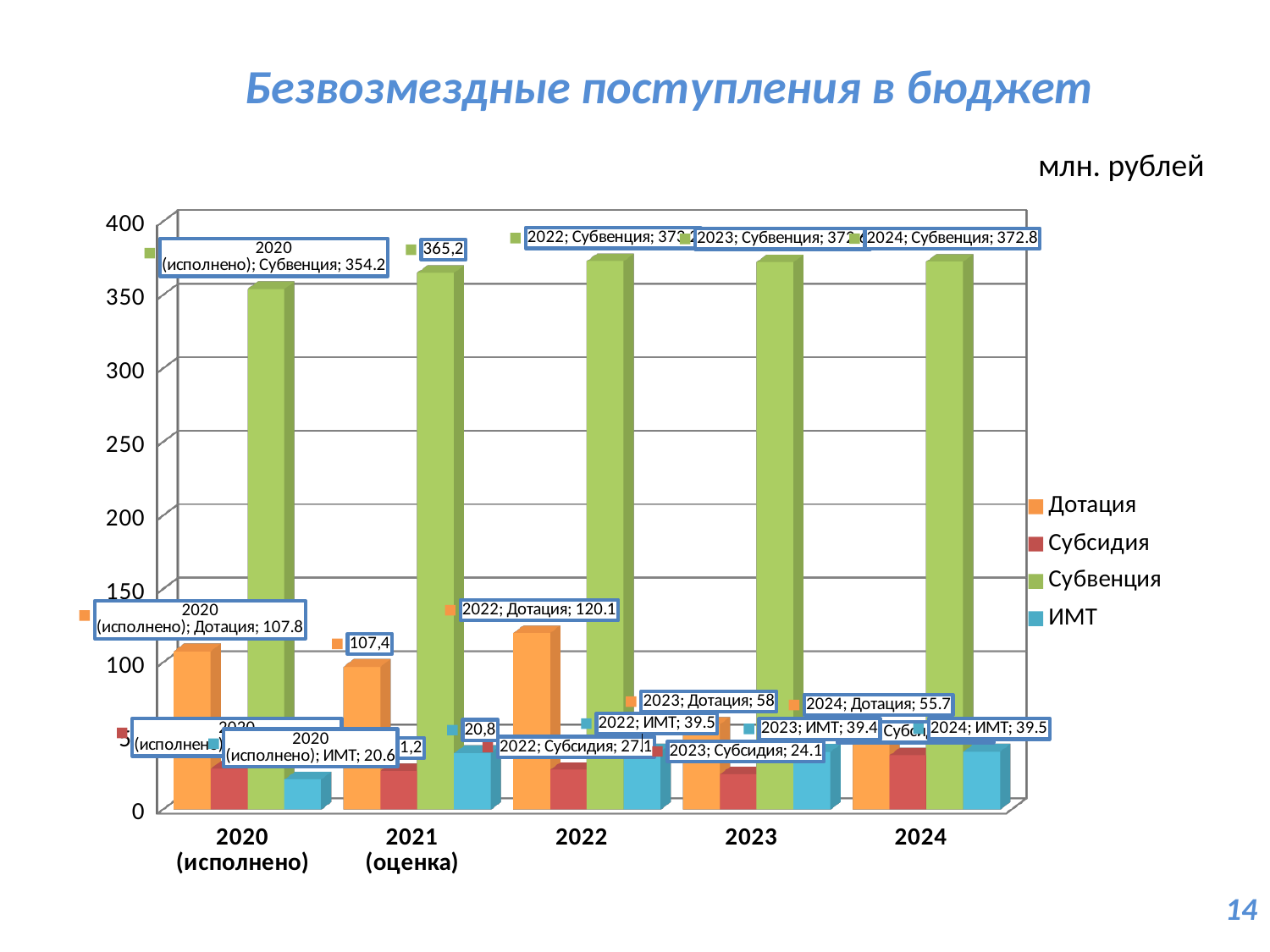
Which series has the highest value in 2024? Субвенция What is the value of Дотация for 2022? 120.1 What is the value of Субсидия for 2022? 27.1 What is the value of Дотация for 2021 (оценка)? 107,4 How many year categories are shown on the x axis? 5 What is the value of ИМТ for 2023? 39.4 By how much does Дотация in 2022 exceed Дотация in 2023? 62.1 What kind of chart is shown on the slide? bar chart What is the value of Субвенция for 2024? 372.8 How many series does the legend list? 4 Which is larger: Дотация in 2020 (исполнено) or Дотация in 2024? 2020 (исполнено) What is the value of Субвенция for 2020 (исполнено)? 354.2